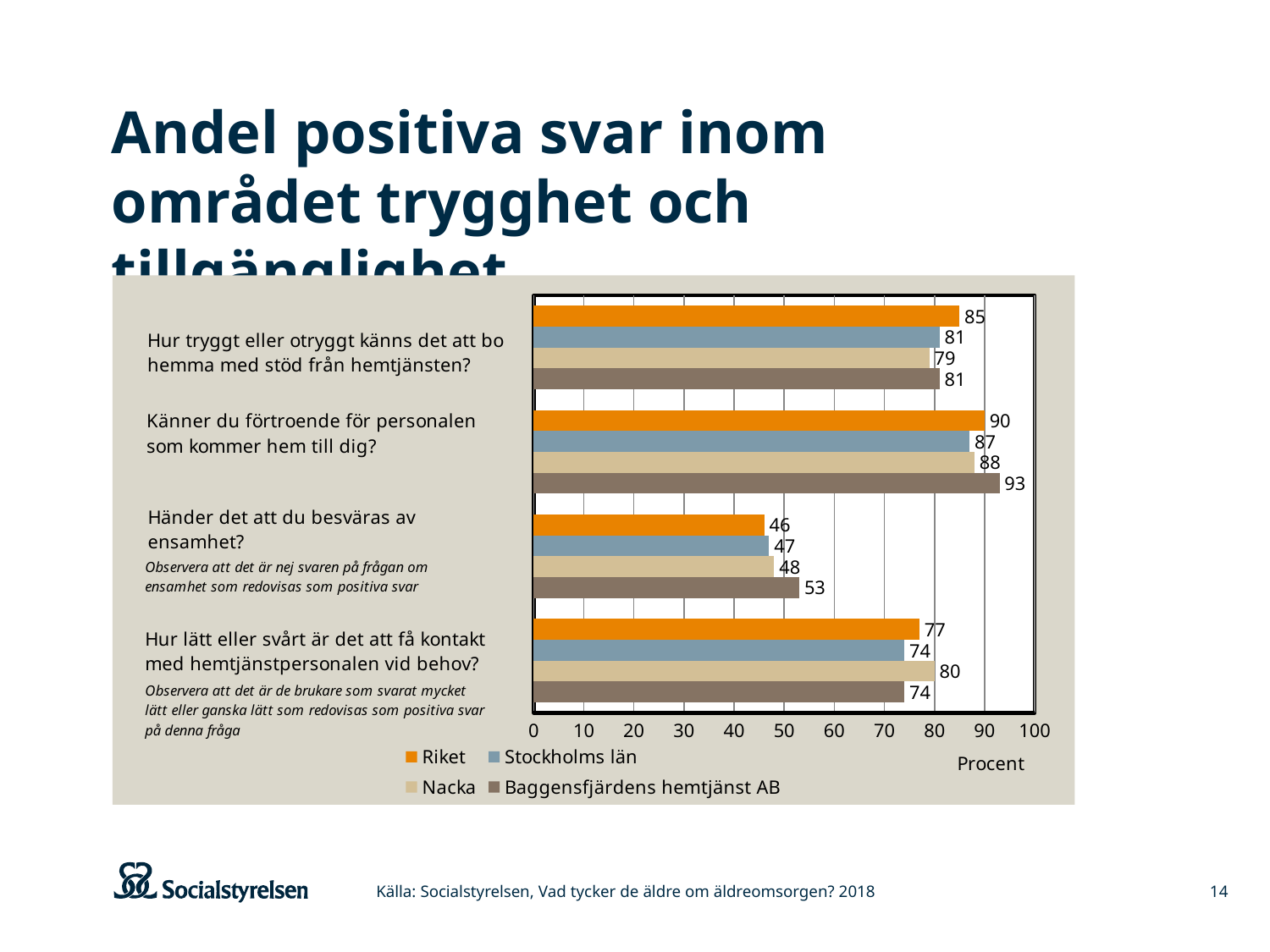
What kind of chart is shown on the slide? Bar chart What is the value for Riket on the question "Känner du förtroende för personalen som kommer hem till dig?"? 90 Is the value for Riket on the question "Hur tryggt eller otryggt känns det att bo hemma med stöd från hemtjänsten?" greater or less than 80? greater What is the value for Baggensfjärdens hemtjänst AB on the question "Händer det att du besväras av ensamhet?"? 53 What is the difference between the Baggensfjärdens hemtjänst AB value and the Riket value on the question "Händer det att du besväras av ensamhet?"? 7 What is the value for Nacka on the question "Hur lätt eller svårt är det att få kontakt med hemtjänstpersonalen vid behov?"? 80 How many series does the legend list? 4 Which is larger on the question "Hur lätt eller svårt är det att få kontakt med hemtjänstpersonalen vid behov?": the value for Nacka or the value for Riket? Nacka How many question categories are shown on the chart? 4 What is the value for Stockholms län on the question "Hur tryggt eller otryggt känns det att bo hemma med stöd från hemtjänsten?"? 81 Which series has the highest value on the question "Känner du förtroende för personalen som kommer hem till dig?"? Baggensfjärdens hemtjänst AB Which series has the lowest value on the question "Händer det att du besväras av ensamhet?"? Riket